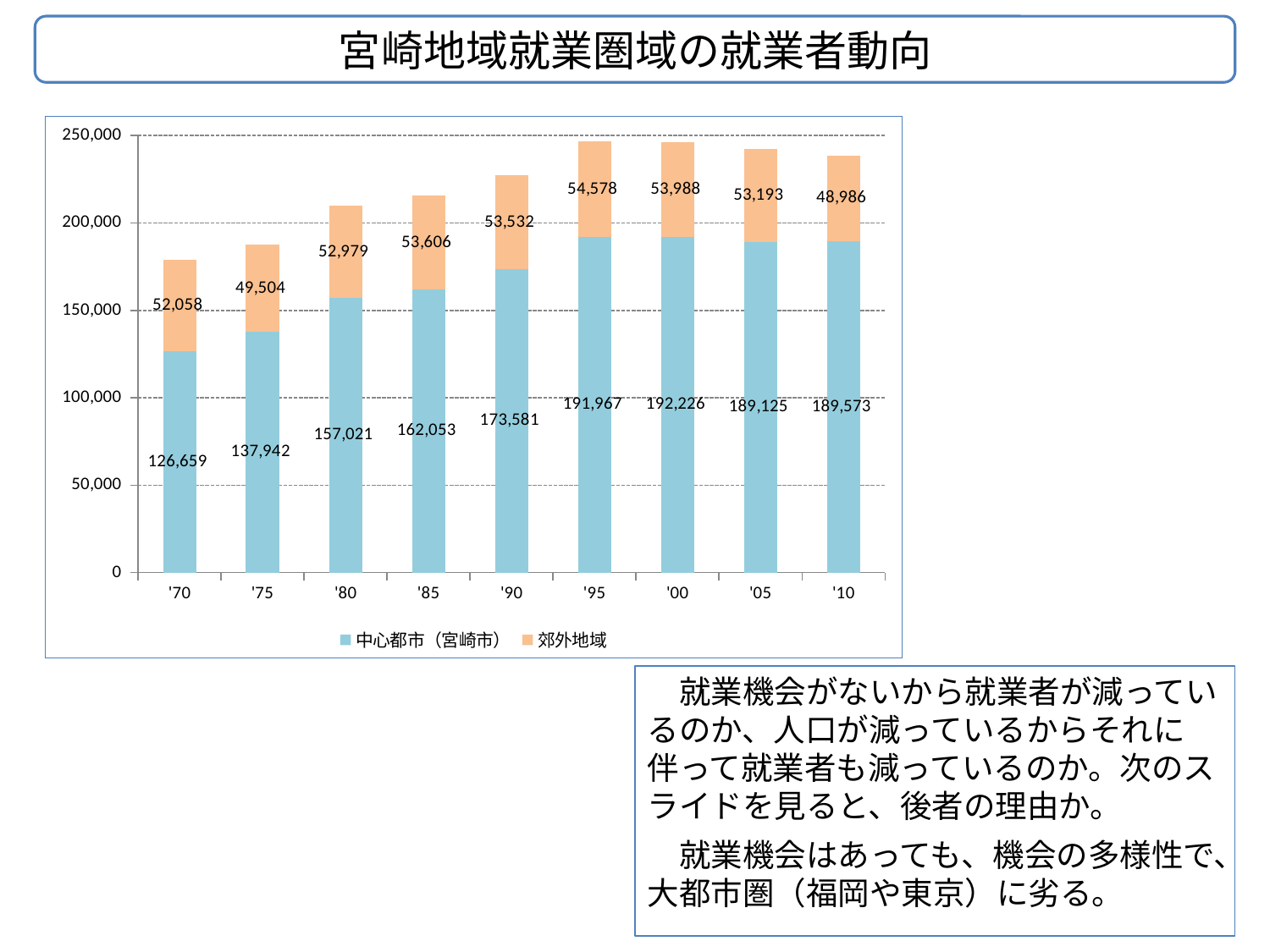
What is the value for 郊外地域 in '95? 54,578 How many years (categories) are shown on the x axis? 9 What is the title of the slide? 宮崎地域就業圏域の就業者動向 What is the difference between the 中心都市（宮崎市） values in '10 and '70? 62,914 What is the total of the stacked bar for '80? 210,000 In which year is the 中心都市（宮崎市） value highest? '00 What is the value for 中心都市（宮崎市） in '70? 126,659 What is the value for 中心都市（宮崎市） in '10? 189,573 How many series does the legend list? 2 What type of chart is shown on the slide? Stacked bar chart Which is larger, the 郊外地域 value in '85 or in '90? '85 In which year is the 郊外地域 value lowest? '10